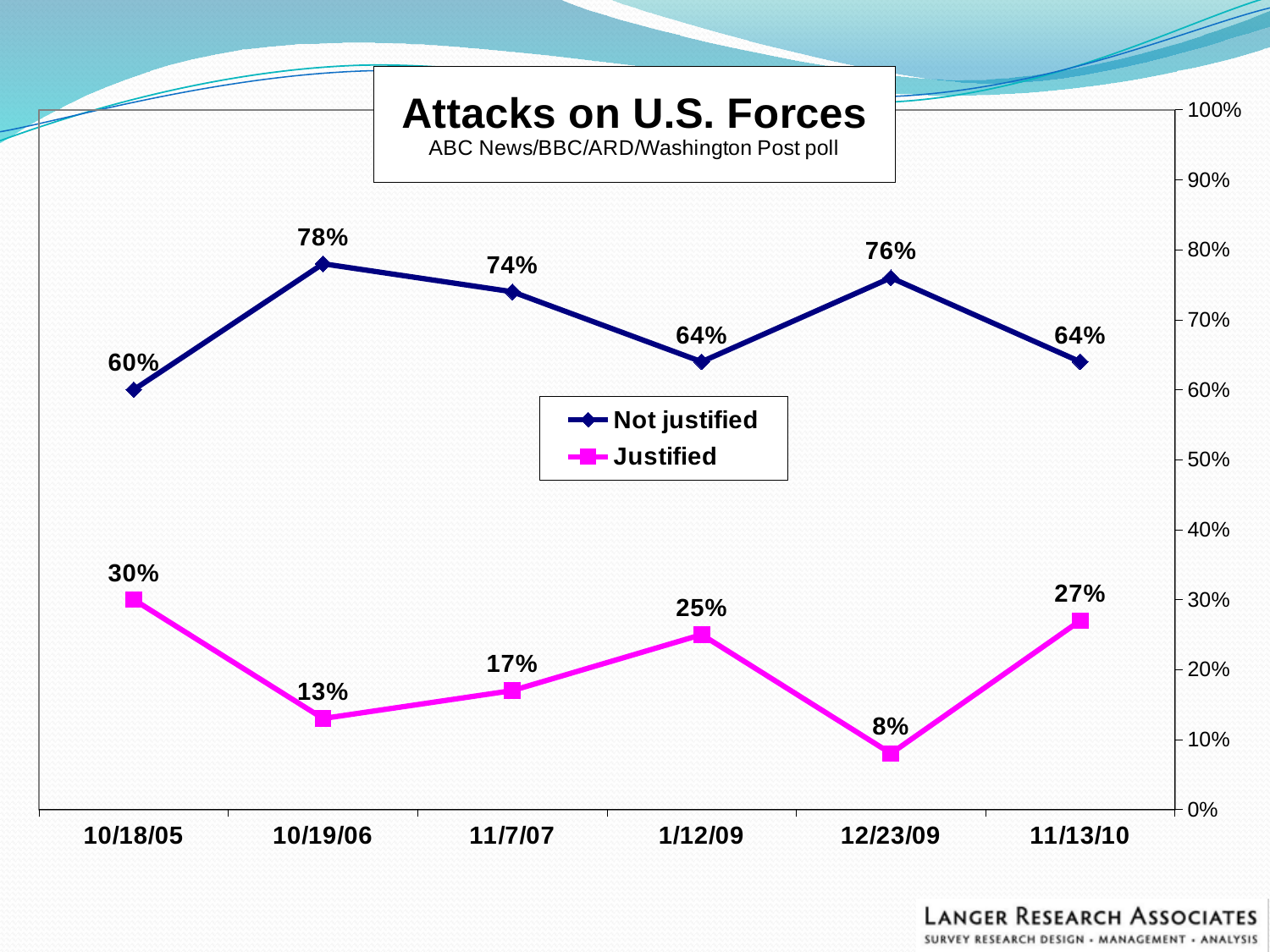
Which is larger on 1/12/09: the Not justified value or the Justified value? Not justified What is the value for Justified on 12/23/09? 8% What kind of chart is shown? line chart What is the value for Not justified on 10/19/06? 78% On which date is the Justified value lowest? 12/23/09 How many dates are plotted on the x axis? 6 Which poll is cited in the chart subtitle? ABC News/BBC/ARD/Washington Post poll Is the Justified value on 10/19/06 greater or less than 20%? less What is the difference between the Not justified and Justified values on 10/18/05? 30% What is the value for Justified on 11/13/10? 27% On which date is the Not justified value highest? 10/19/06 How many series does the legend list? 2